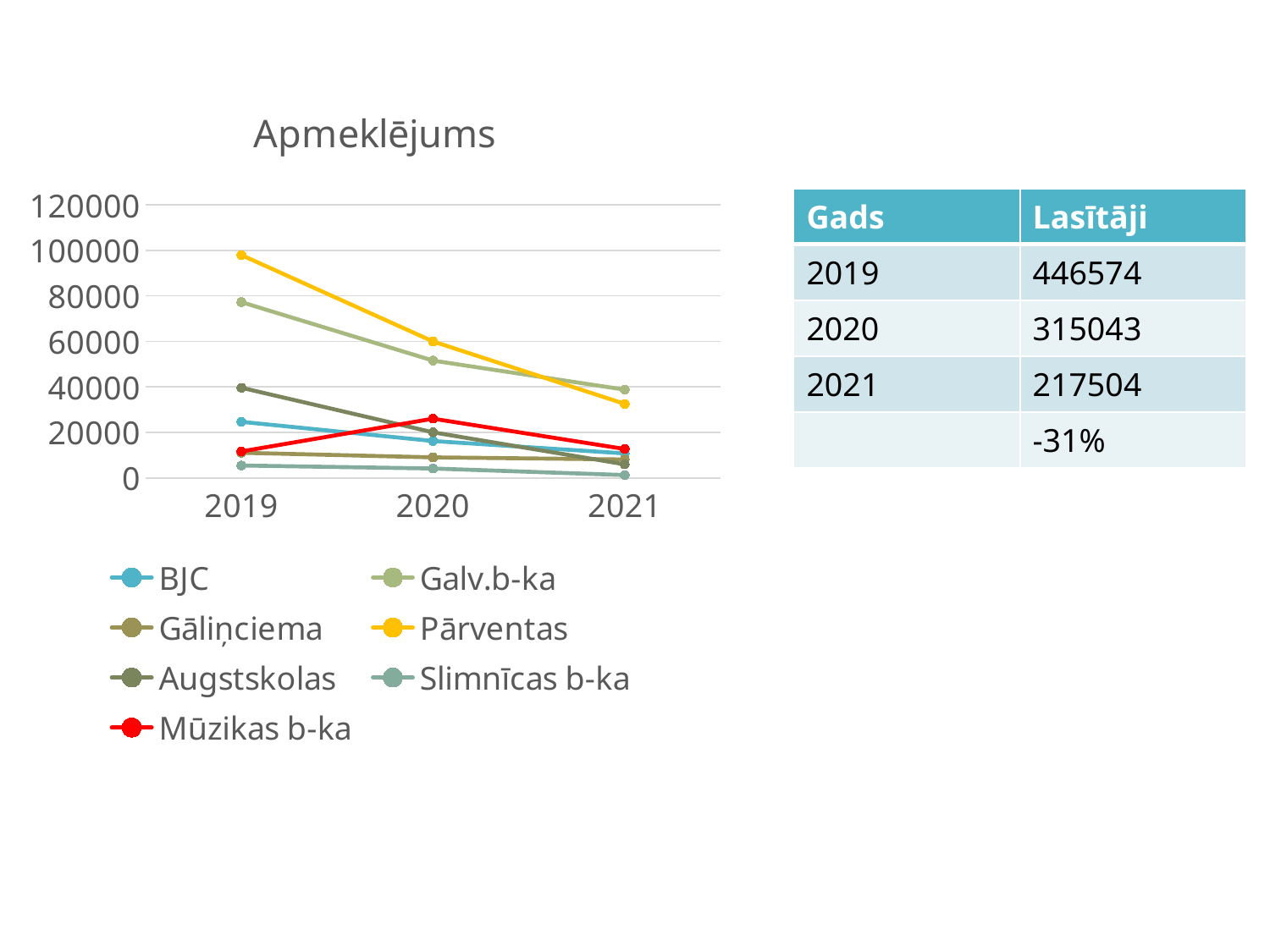
Is the value for Pārventas in 2019 greater or less than 80000? greater In 2019, which is larger: the value for BJC or the value for Augstskolas? Augstskolas In 2020, which is larger: the value for Pārventas or the value for Galv.b-ka? Pārventas What is the title of the chart? Apmeklējums How many years are plotted along the x axis of the chart? 3 Is the value for Augstskolas in 2019 greater or less than 60000? less What kind of chart is shown on the slide? line chart Is the value for Mūzikas b-ka in 2020 greater or less than 20000? greater Does the value for Pārventas rise or fall from 2019 to 2021? fall Which series has the highest value in 2019? Pārventas How many series does the chart legend list? 7 Which series has the lowest value in 2021? Slimnīcas b-ka